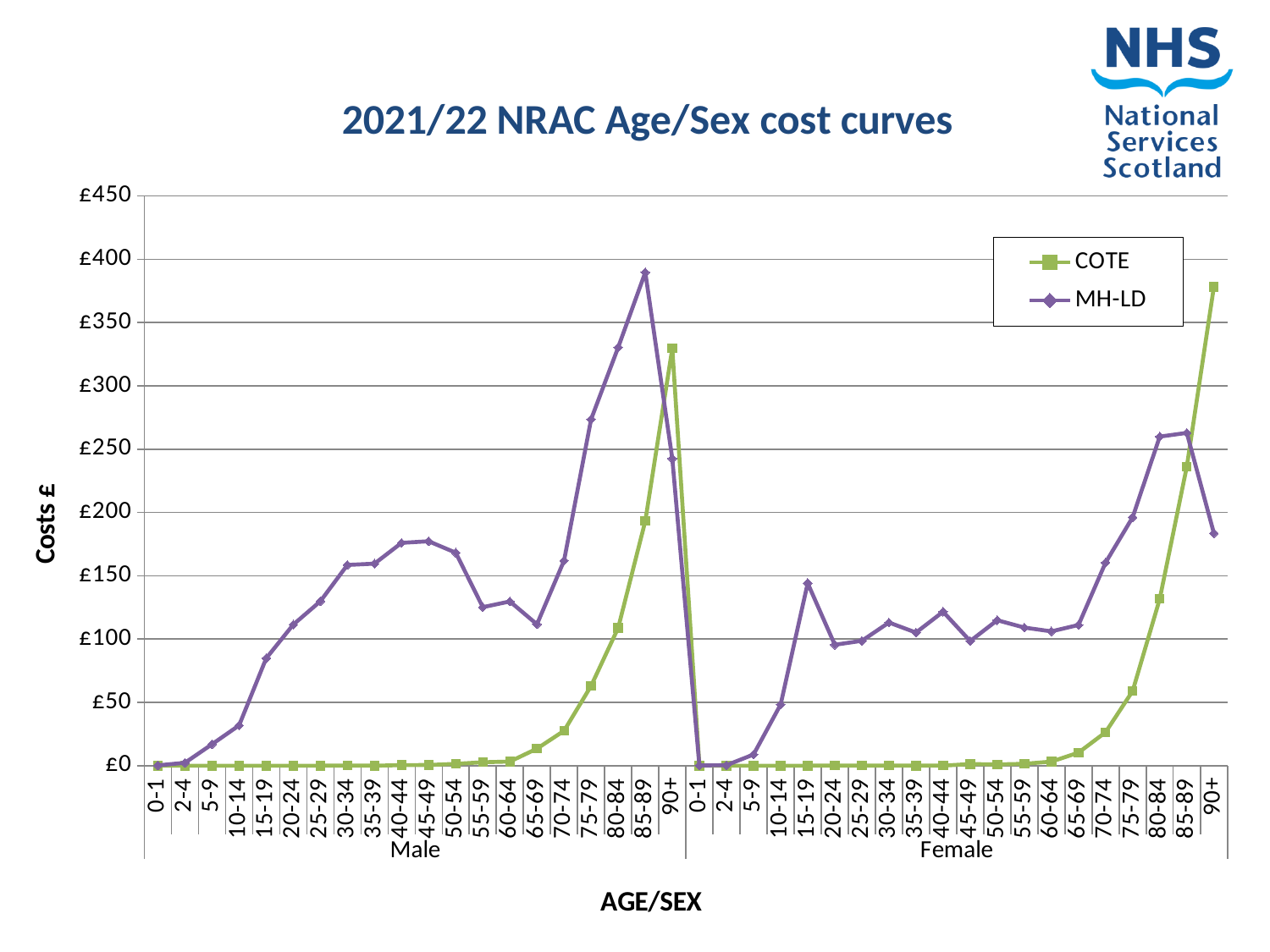
At which age/sex group does the MH-LD series reach its highest value? Male 85-89 Is the MH-LD value for Male 85-89 greater or less than £350? greater Is the COTE value for Female 85-89 greater or less than £250? less Is the COTE value for Female 90+ greater or less than £350? greater Does the COTE series for Male rise or fall from 65-69 to 90+? rise How many age-group points are plotted for each series across both Male and Female? 40 How many series does the legend list? 2 What is the title of the chart? 2021/22 NRAC Age/Sex cost curves What is the label on the vertical axis? Costs £ What kind of chart is shown on the slide? Line chart Which is larger, the COTE value for Male 90+ or the COTE value for Female 90+? Female 90+